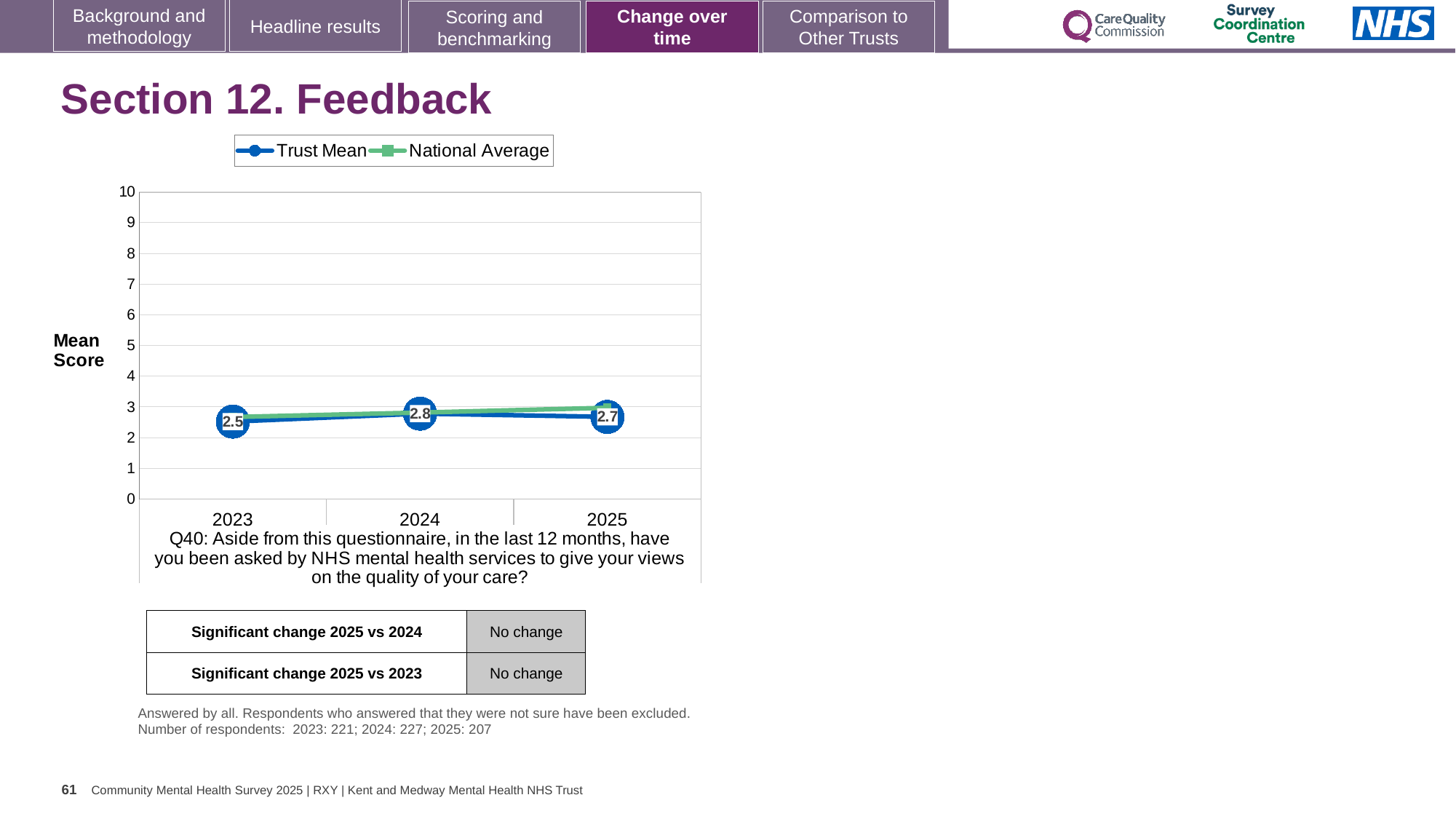
What is the difference between the Trust Mean in 2024 and in 2023? 0.3 What is the Trust Mean value for 2023? 2.5 Does the Trust Mean rise or fall from 2023 to 2024? rise What is the Trust Mean value for 2024? 2.8 In which year is the Trust Mean lowest? 2023 Which is larger, the Trust Mean in 2023 or in 2025? 2025 What kind of chart is shown on the slide? line chart How many years are plotted on the x axis? 3 What is the Trust Mean value for 2025? 2.7 In which year is the Trust Mean highest? 2024 Is the Trust Mean value for 2023 greater or less than 5? less How many series does the legend list? 2